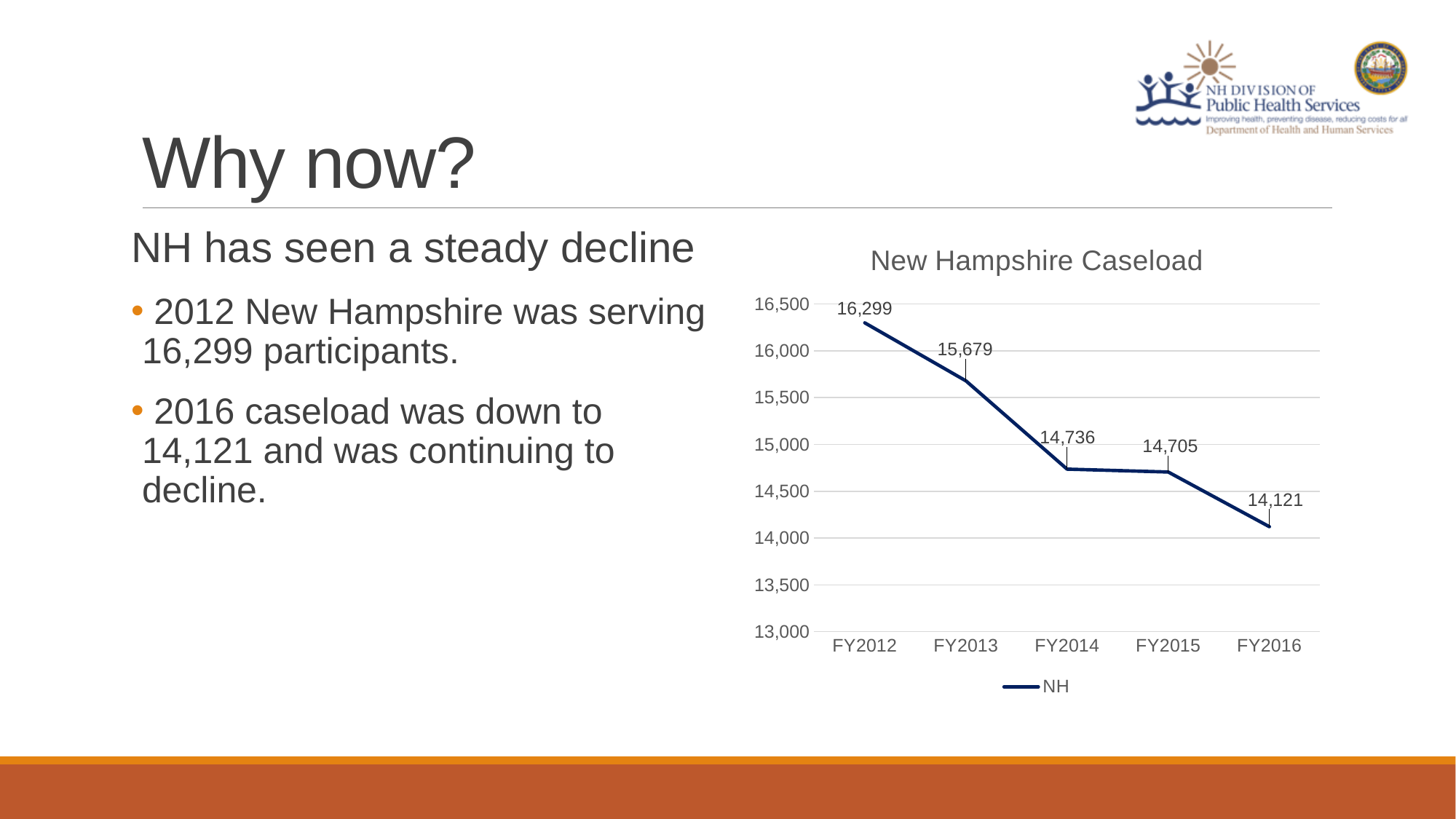
Which fiscal year has the highest caseload? FY2012 What kind of chart is shown on the slide? line chart Which is larger, the caseload for FY2013 or FY2015? FY2013 What is the difference between the FY2012 and FY2016 caseloads? 2,178 How many fiscal years are plotted on the chart? 5 Is the caseload for FY2015 greater or less than 15,000? less What is the New Hampshire caseload for FY2016? 14,121 What is the New Hampshire caseload for FY2012? 16,299 What is the New Hampshire caseload for FY2014? 14,736 What is the difference between the FY2013 and FY2014 caseloads? 943 Which fiscal year has the lowest caseload? FY2016 Does the caseload rise or fall from FY2012 to FY2016? fall